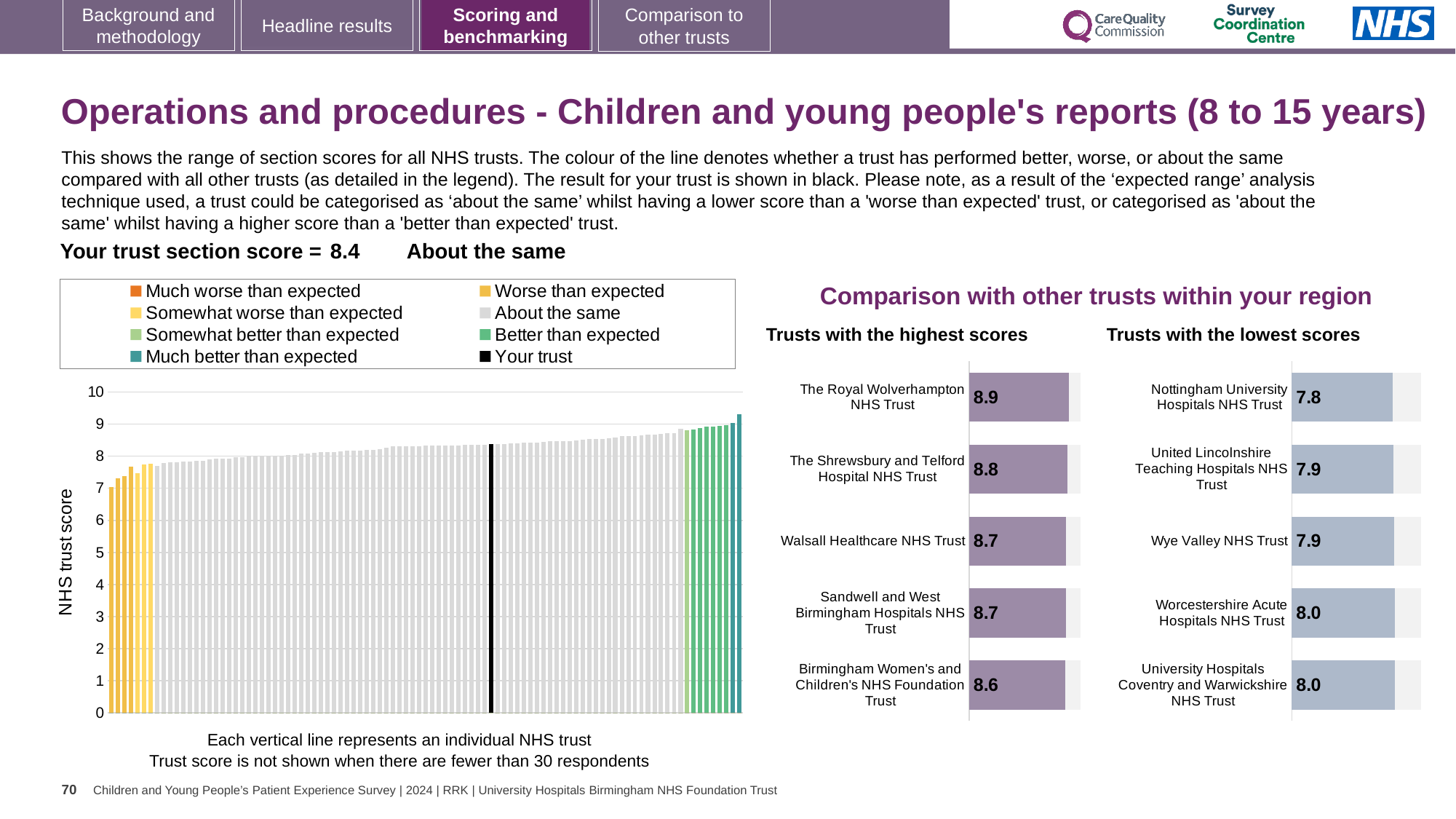
In the 'Trusts with the highest scores' chart, which trust has the lowest score? Birmingham Women's and Children's NHS Foundation Trust In the 'Trusts with the highest scores' chart, what is the score for The Royal Wolverhampton NHS Trust? 8.9 In the 'Trusts with the lowest scores' chart, which trust has the lowest score? Nottingham University Hospitals NHS Trust How many trusts are shown in the 'Trusts with the highest scores' chart? 5 How many entries does the legend of the large chart on the left list? 8 In the large chart on the left, is the value of the black bar (your trust) greater or less than 9? less In the 'Trusts with the lowest scores' chart, which has the larger score: Wye Valley NHS Trust or Nottingham University Hospitals NHS Trust? Wye Valley NHS Trust In the 'Trusts with the lowest scores' chart, what is the difference between the scores of Worcestershire Acute Hospitals NHS Trust and Nottingham University Hospitals NHS Trust? 0.2 In the 'Trusts with the highest scores' chart, what is the difference between the scores of The Royal Wolverhampton NHS Trust and Birmingham Women's and Children's NHS Foundation Trust? 0.3 In the large chart on the left, do the trust scores rise or fall from left to right? Rise What type of chart is the large chart on the left showing NHS trust scores? Bar chart In the 'Trusts with the lowest scores' chart, what is the score for Nottingham University Hospitals NHS Trust? 7.8